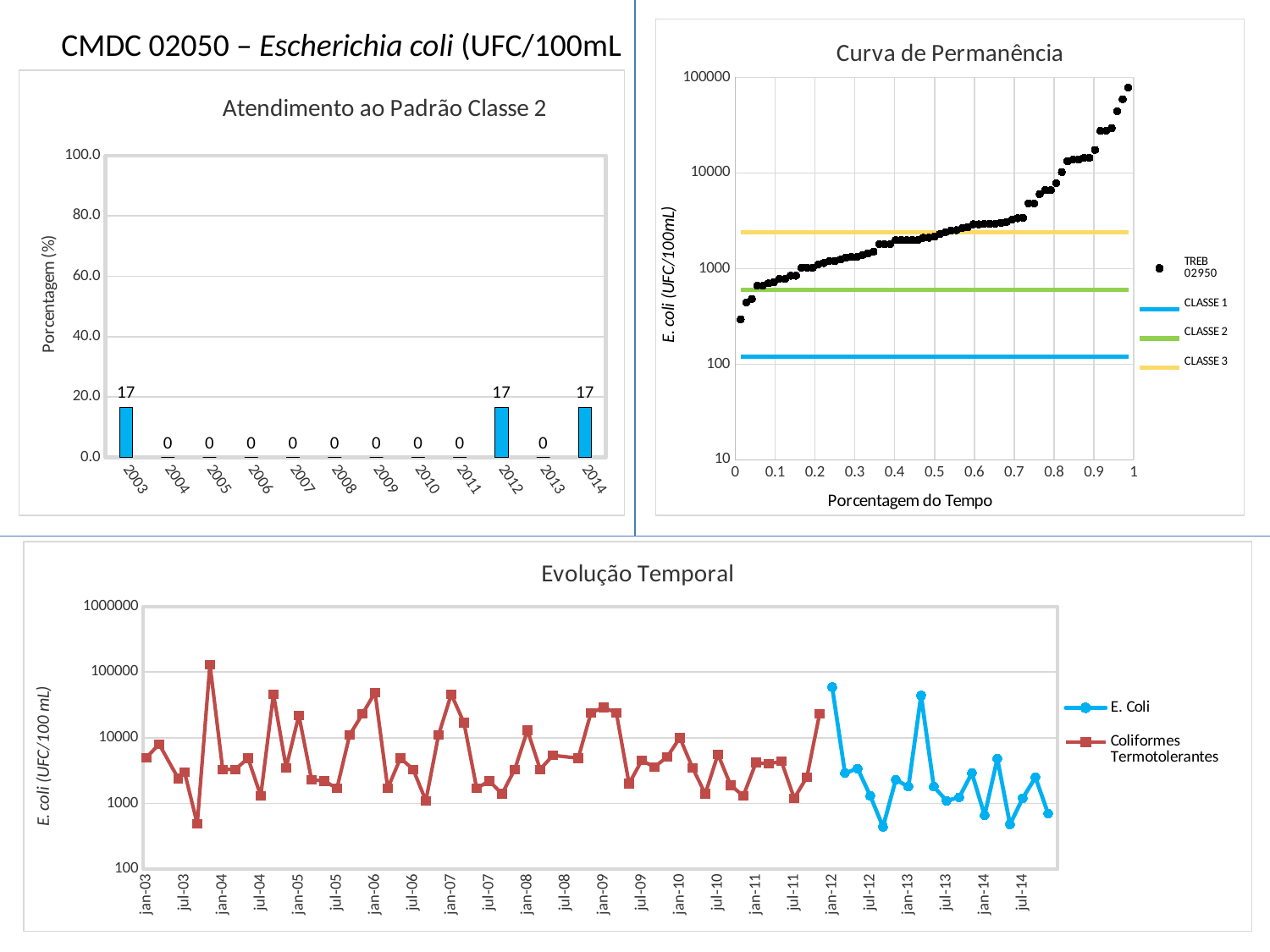
In the 'Curva de Permanência' chart, do the TREB 02950 values rise or fall as Porcentagem do Tempo increases? rise In the 'Evolução Temporal' chart, how many series does the legend list? 2 In the 'Atendimento ao Padrão Classe 2' chart, how many years are shown on the x axis? 12 In the 'Atendimento ao Padrão Classe 2' chart, what is the difference between the values for 2012 and 2011? 17 In the 'Curva de Permanência' chart, is the CLASSE 1 line greater or less than 1000? less In the 'Atendimento ao Padrão Classe 2' chart, what is the value for 2013? 0 In the 'Curva de Permanência' chart, how many entries does the legend list? 4 In the 'Atendimento ao Padrão Classe 2' chart, which is larger, the value for 2014 or the value for 2013? 2014 In the 'Evolução Temporal' chart, what colour is the E. Coli series? blue In the 'Atendimento ao Padrão Classe 2' chart, what is the value for 2008? 0 In the 'Atendimento ao Padrão Classe 2' chart, what is the value for 2003? 17 What kind of chart is 'Atendimento ao Padrão Classe 2'? bar chart